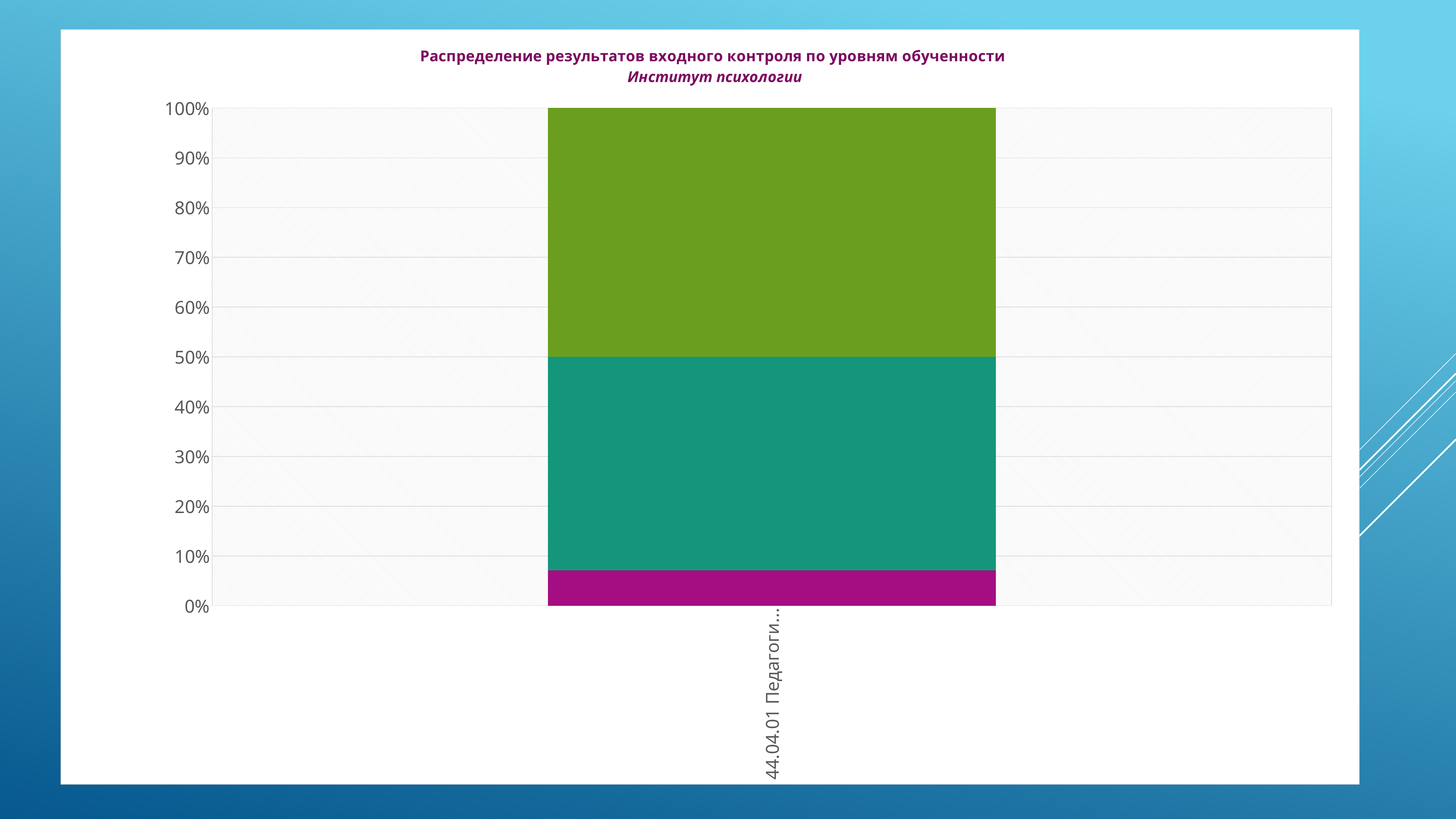
Which is larger, the green segment or the purple segment? the green segment How many bars (categories) are plotted on the chart? 1 What kind of chart is shown on the slide? stacked bar chart Is the value of the purple (bottom) segment greater or less than 10%? less At what percentage on the axis does the boundary between the teal and green segments lie? 50% Which segment of the bar is the smallest? the purple (bottom) segment Is the value of the teal (middle) segment greater or less than 40%? greater What subtitle appears under the chart title? Институт психологии What is the highest value shown on the vertical axis? 100% How many coloured segments make up the bar? 3 What is the title of the chart? Распределение результатов входного контроля по уровням обученности What is the total height of the stacked bar on the percentage axis? 100%